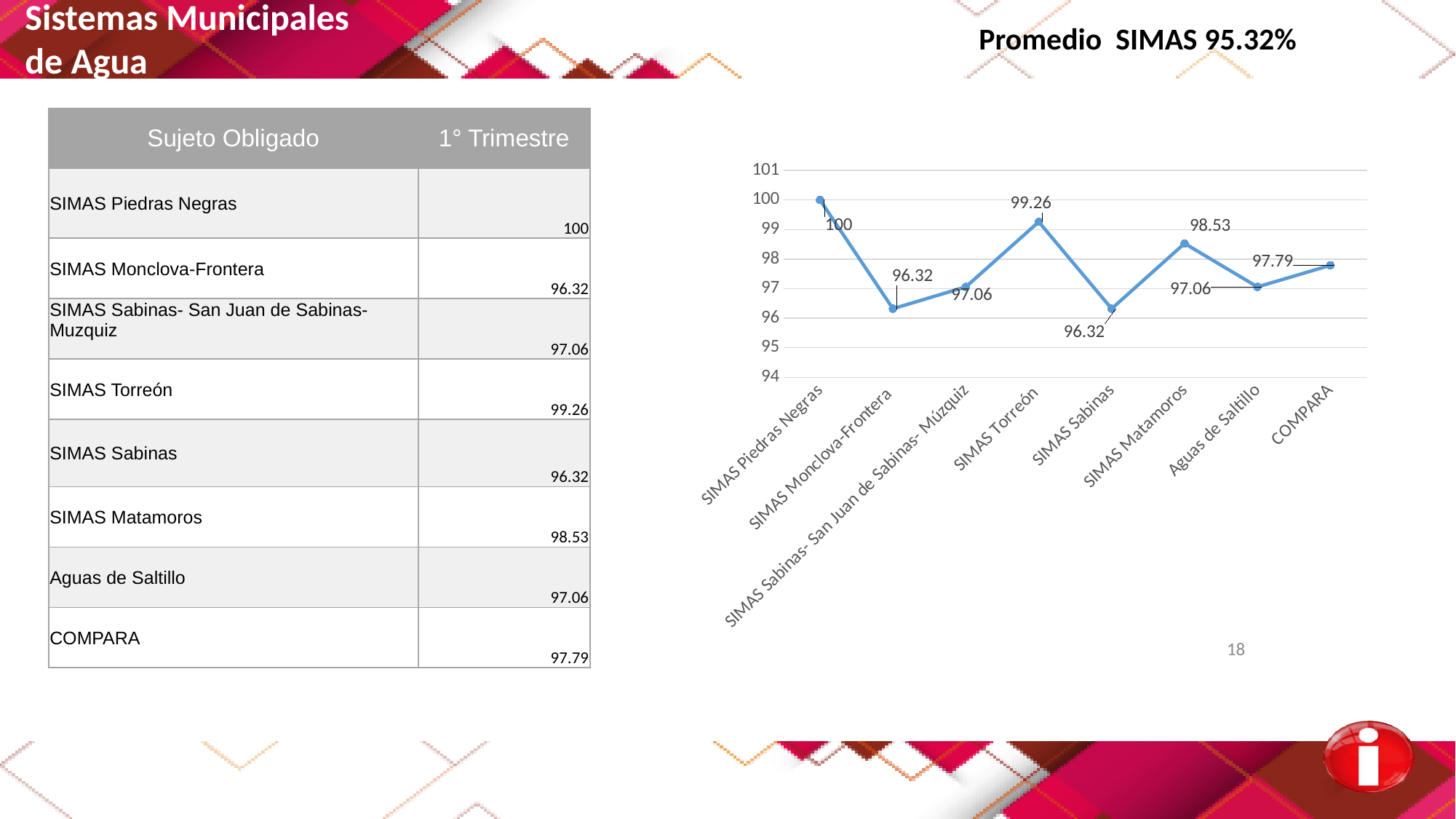
What is the value for SIMAS Matamoros in the chart? 98.53 What is the value for Aguas de Saltillo in the chart? 97.06 What type of chart is shown on the slide? line chart Which category has the highest value in the chart? SIMAS Piedras Negras What is the difference between the values for SIMAS Piedras Negras and SIMAS Monclova-Frontera? 3.68 Is the value for SIMAS Sabinas greater or less than 97? less Which is larger, the value for SIMAS Matamoros or the value for COMPARA? SIMAS Matamoros What is the value for COMPARA in the chart? 97.79 What is the difference between the values for SIMAS Torreón and SIMAS Matamoros? 0.73 Do the values rise or fall from SIMAS Sabinas to SIMAS Matamoros? rise What is the value for SIMAS Torreón in the chart? 99.26 How many categories are plotted on the x axis of the chart? 8